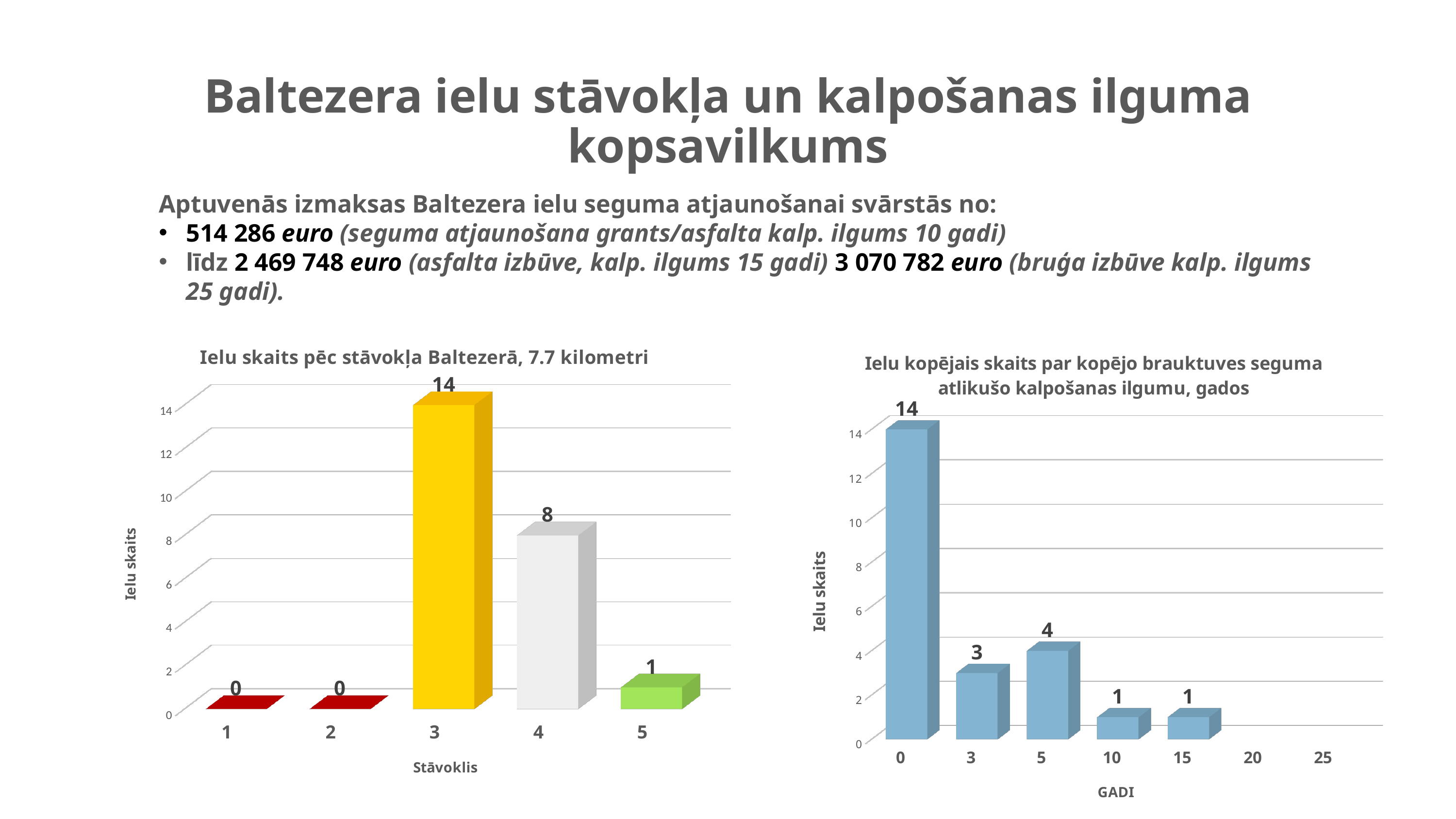
What kind of chart is the right chart 'Ielu kopējais skaits par kopējo brauktuves seguma atlikušo kalpošanas ilgumu, gados'? Bar chart In the left chart 'Ielu skaits pēc stāvokļa Baltezerā, 7.7 kilometri', which Stāvoklis category has the highest value? 3 In the right chart 'Ielu kopējais skaits par kopējo brauktuves seguma atlikušo kalpošanas ilgumu, gados', which is larger, the value for 3 GADI or 5 GADI? 5 GADI What is the y-axis label of the left chart 'Ielu skaits pēc stāvokļa Baltezerā, 7.7 kilometri'? Ielu skaits In the left chart 'Ielu skaits pēc stāvokļa Baltezerā, 7.7 kilometri', what is the value for Stāvoklis 3? 14 In the left chart 'Ielu skaits pēc stāvokļa Baltezerā, 7.7 kilometri', how many Stāvoklis categories are shown on the x axis? 5 In the right chart 'Ielu kopējais skaits par kopējo brauktuves seguma atlikušo kalpošanas ilgumu, gados', what is the value for 5 GADI? 4 In the left chart 'Ielu skaits pēc stāvokļa Baltezerā, 7.7 kilometri', what is the value for Stāvoklis 5? 1 In the right chart 'Ielu kopējais skaits par kopējo brauktuves seguma atlikušo kalpošanas ilgumu, gados', what is the value for 0 GADI? 14 In the left chart 'Ielu skaits pēc stāvokļa Baltezerā, 7.7 kilometri', what is the value for Stāvoklis 4? 8 In the right chart 'Ielu kopējais skaits par kopējo brauktuves seguma atlikušo kalpošanas ilgumu, gados', what is the difference between the values for 0 GADI and 3 GADI? 11 In the left chart 'Ielu skaits pēc stāvokļa Baltezerā, 7.7 kilometri', what is the difference between the values for Stāvoklis 3 and Stāvoklis 4? 6